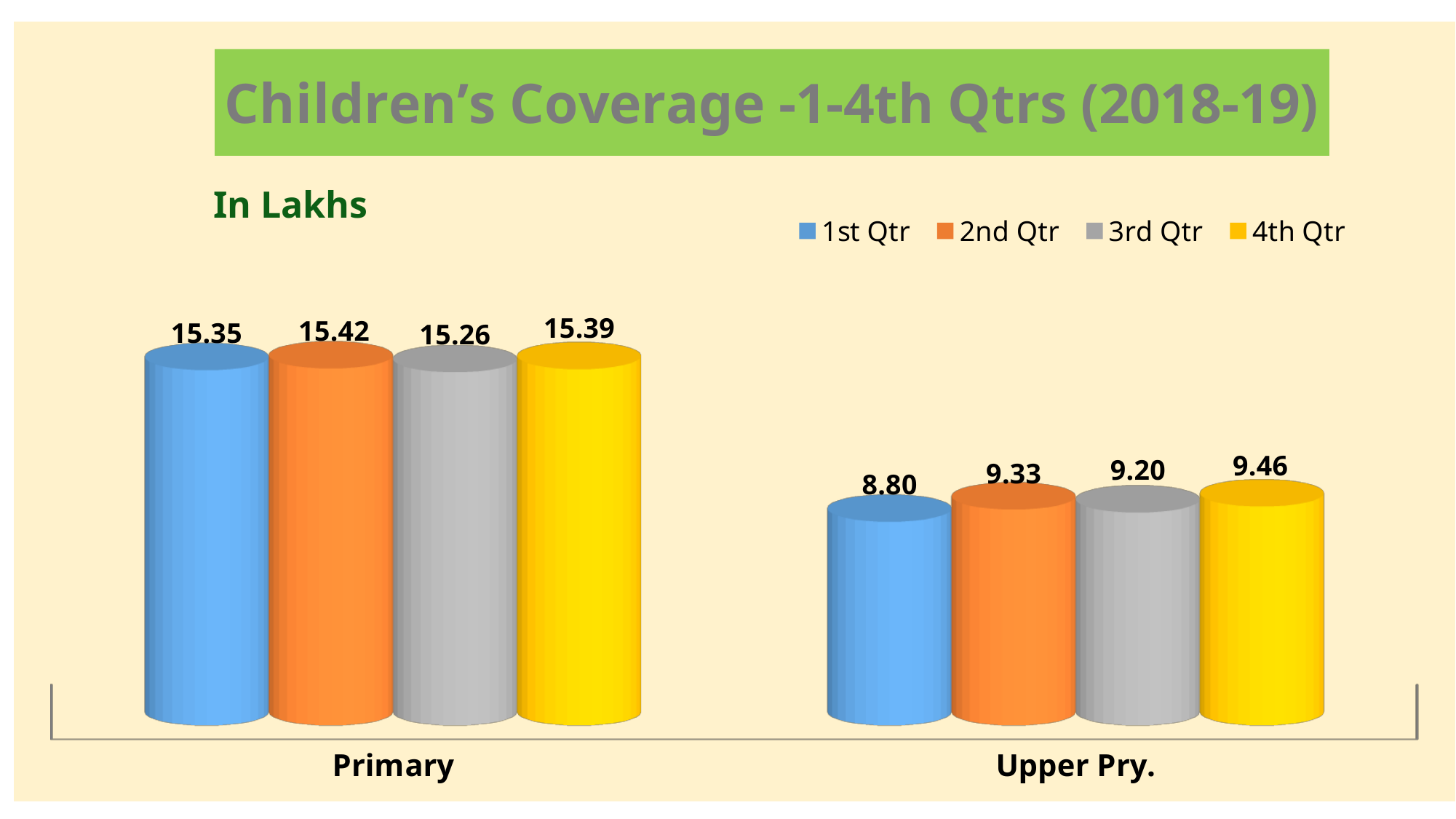
What kind of chart is shown on the slide? Bar chart How many series does the legend list? 4 What is the value for 3rd Qtr in the Primary category? 15.26 How many categories are shown on the x axis? 2 What is the value for 4th Qtr in the Upper Pry. category? 9.46 What is the difference between the 2nd Qtr and 1st Qtr values in the Upper Pry. category? 0.53 Which quarter has the highest value in the Primary category? 2nd Qtr Which is larger: the 3rd Qtr value for Primary or the 3rd Qtr value for Upper Pry.? Primary Which quarter has the lowest value in the Upper Pry. category? 1st Qtr What is the value for 1st Qtr in the Primary category? 15.35 What is the difference between the 1st Qtr values for Primary and Upper Pry.? 6.55 Which quarter has the highest value in the Upper Pry. category? 4th Qtr